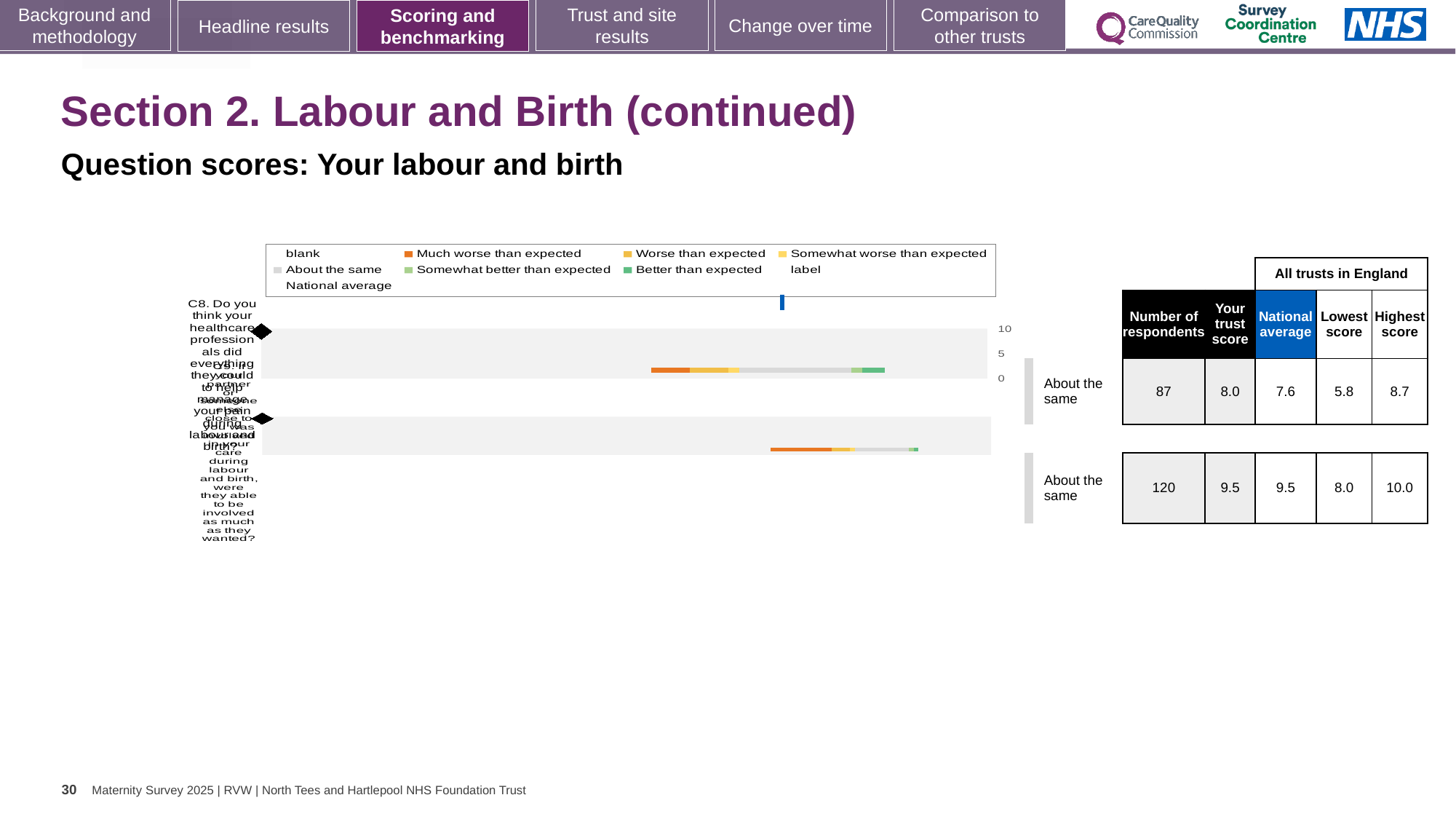
What is the difference between the highest score and the lowest score for the first (top) question row, C8? 2.9 In the chart legend, what colour represents 'Much worse than expected'? orange In the chart legend, what colour represents 'Better than expected'? green What is the national average for the first (top) question row, C8? 7.6 What is the number of respondents for the first (top) question row, C8? 87 What is the number of respondents for the second (bottom) question row? 120 What is the difference between the highest score and the lowest score for the second (bottom) question row? 2.0 For the first (top) question row, C8, which is larger: the trust score or the national average? trust score What kind of chart is shown on the slide? bar chart What is the highest score among all trusts in England for the second (bottom) question row? 10.0 How many question rows (bars) are plotted in the chart? 2 What is the trust score for the first (top) question row, C8? 8.0